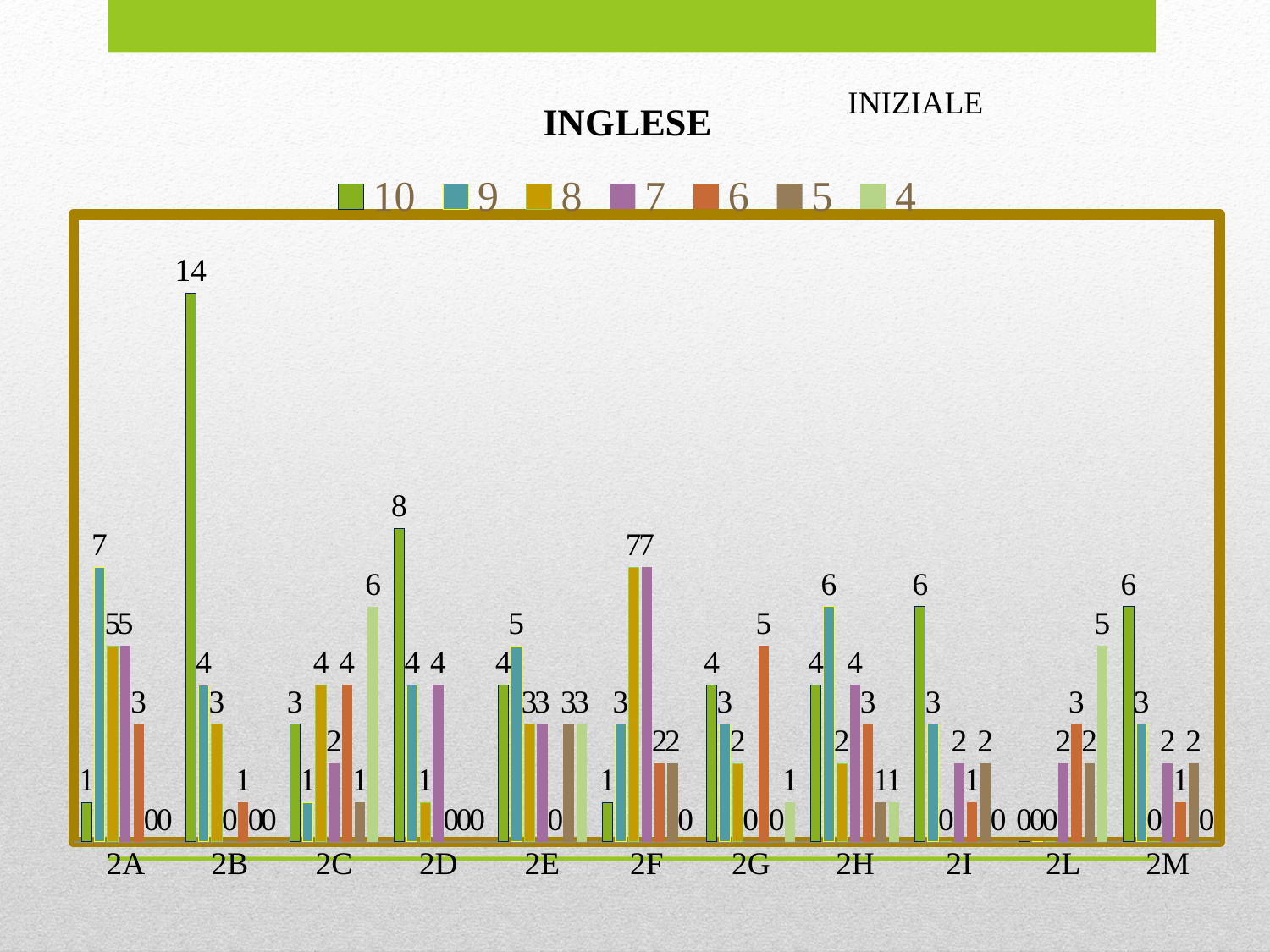
What is the difference between the series 10 values for 2B and 2D? 6 What is the value of series 4 for category 2C? 6 How many categories are shown on the x axis? 11 What is the value of series 9 for category 2A? 7 Which category has the highest value for series 9? 2A How many series does the legend list? 7 What is the value of series 10 for category 2D? 8 What is the value of series 10 for category 2B? 14 What type of chart is shown on the slide? bar chart What is the value of series 6 for category 2G? 5 Which category has the highest value for series 10? 2B Which is larger: the series 9 value for 2A or the series 9 value for 2H? 2A